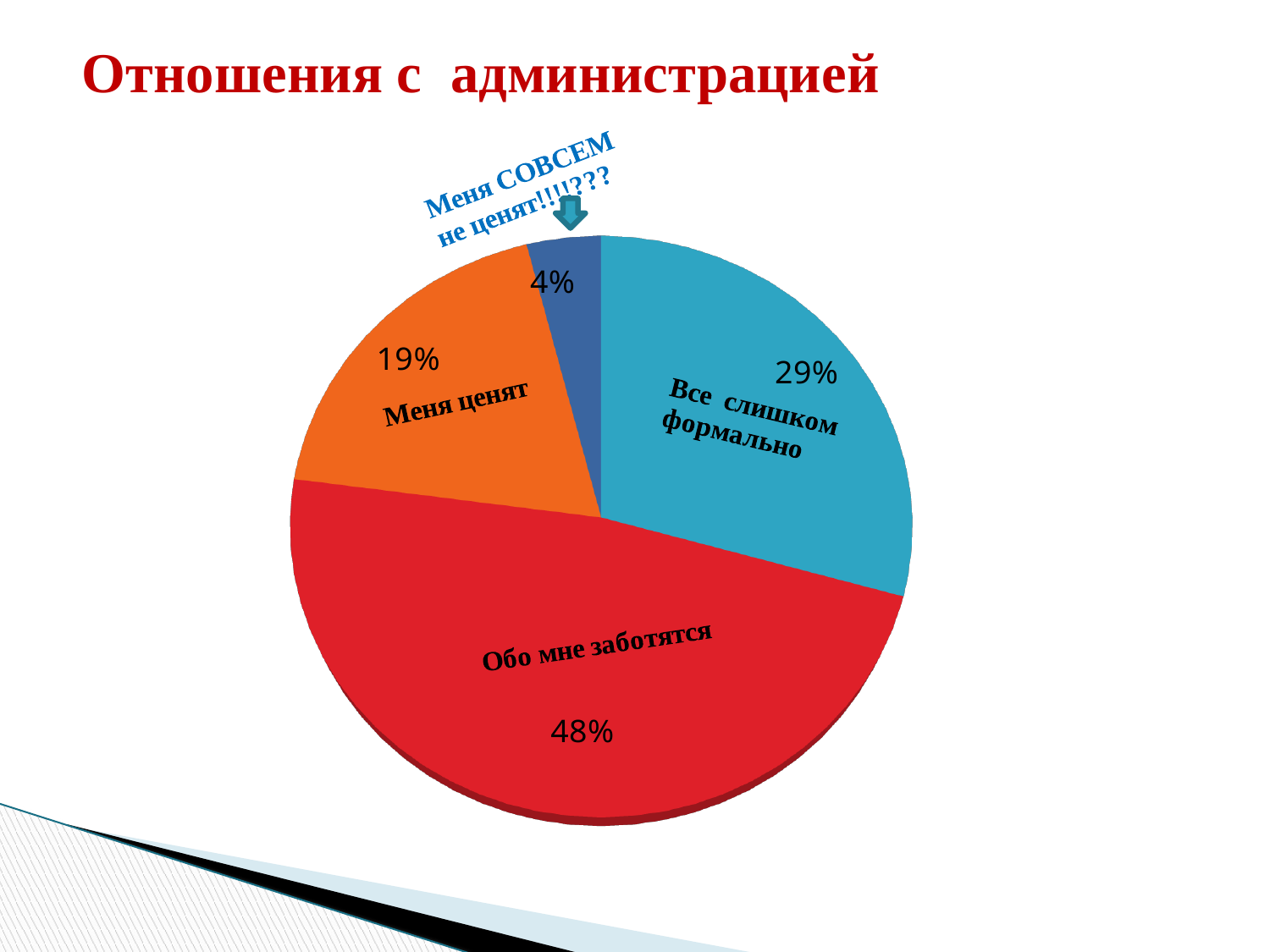
What colour is the "Обо мне заботятся" slice? red Which is larger: the "Меня ценят" slice or the "Все слишком формально" slice? Все слишком формально Which slice of the pie is the largest? Обо мне заботятся What type of chart is shown on the slide? pie chart How many slices does the pie chart have? 4 What percentage is shown for the slice labelled "Меня СОВСЕМ не ценят!!!!???"? 4% What is the title of the slide? Отношения с администрацией What percentage is shown for the slice labelled "Меня ценят"? 19% What percentage is shown for the slice labelled "Все слишком формально"? 29% What percentage is shown for the slice labelled "Обо мне заботятся"? 48% Which slice of the pie is the smallest? Меня СОВСЕМ не ценят!!!!??? What is the difference between the "Обо мне заботятся" slice and the "Все слишком формально" slice? 19%